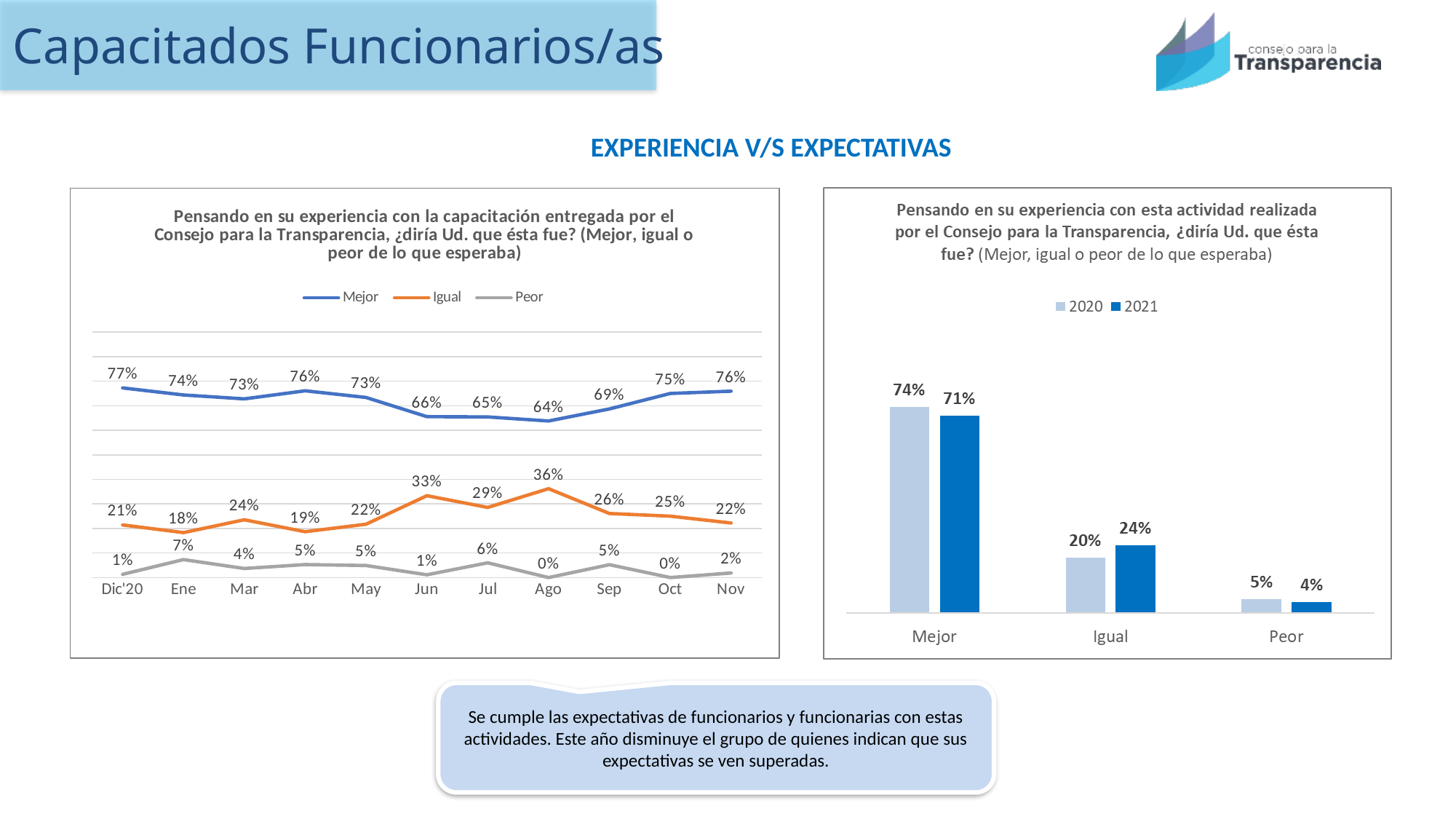
In the left line chart, what is the value of the Peor series for Ene? 7% In the right bar chart, what is the 2021 value for Igual? 24% In the left line chart, in which month is the Igual series highest? Ago In the left line chart, in which month is the Mejor series lowest? Ago In the left line chart, what is the value of the Mejor series for Dic'20? 77% In the right bar chart, what is the difference between the 2020 and 2021 values for Peor? 1% In the left line chart, how many months are shown on the x axis? 11 In the left line chart, how many series does the legend list? 3 In the left line chart, what is the difference between the Mejor value for Dic'20 and the Mejor value for Ago? 13% What type of chart is the chart on the right? Bar chart In the left line chart, what is the value of the Igual series for Ago? 36% In the right bar chart, which is larger for Mejor: the 2020 value or the 2021 value? 2020